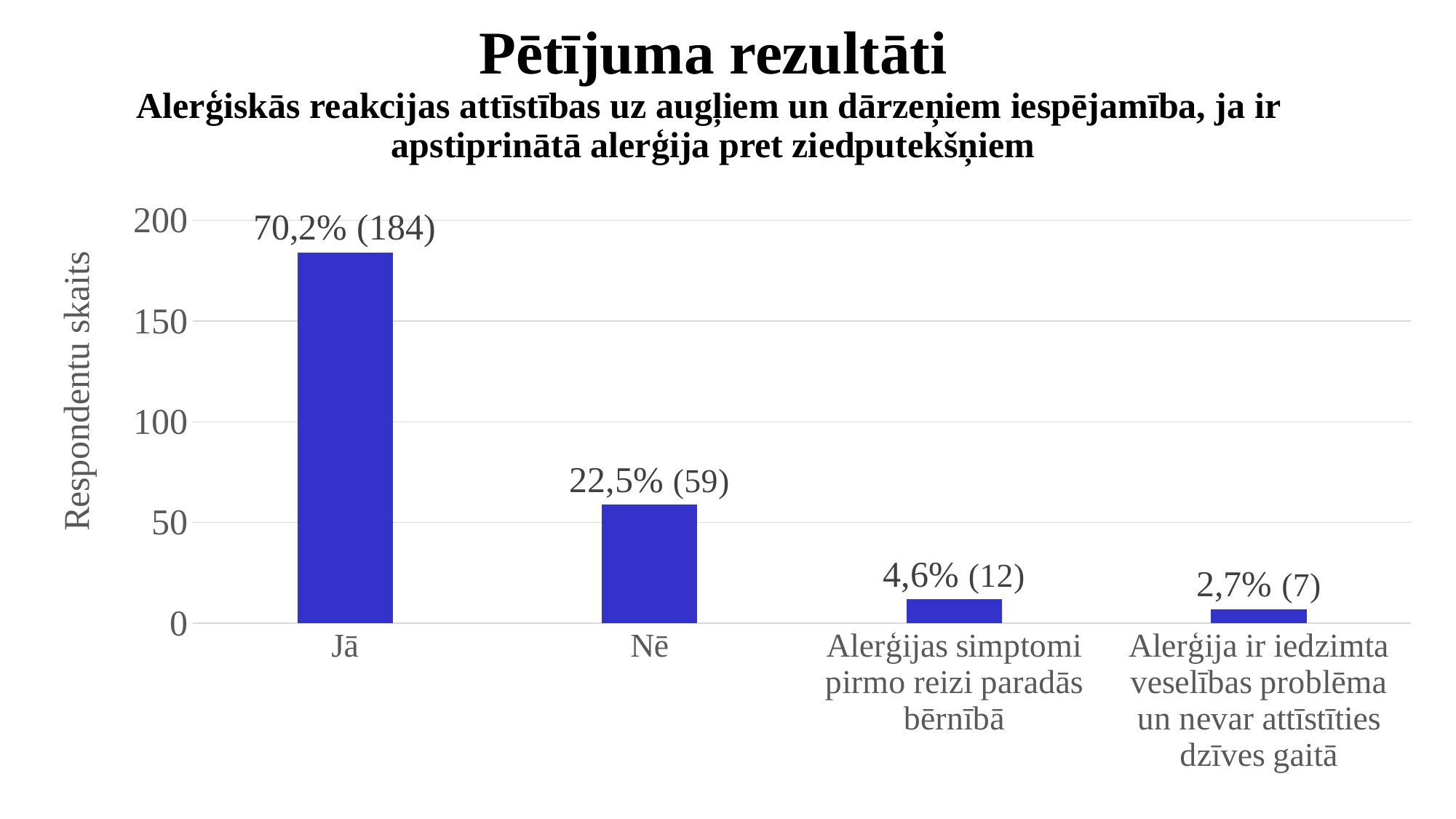
What is the data label shown for the "Jā" bar? 70,2% (184) Which category has the highest number of respondents? Jā Is the value for "Jā" greater or less than 150? greater How many respondents answered "Nē"? 59 What is the difference in respondent count between "Jā" and "Nē"? 125 What percentage is shown for "Alerģijas simptomi pirmo reizi paradās bērnībā"? 4,6% Which category has the lowest number of respondents? Alerģija ir iedzimta veselības problēma un nevar attīstīties dzīves gaitā What is the label of the vertical axis? Respondentu skaits What kind of chart is shown on the slide? Bar chart How many categories are shown on the x axis? 4 How many respondents chose "Alerģija ir iedzimta veselības problēma un nevar attīstīties dzīves gaitā"? 7 Which has more respondents: "Nē" or "Alerģijas simptomi pirmo reizi paradās bērnībā"? Nē